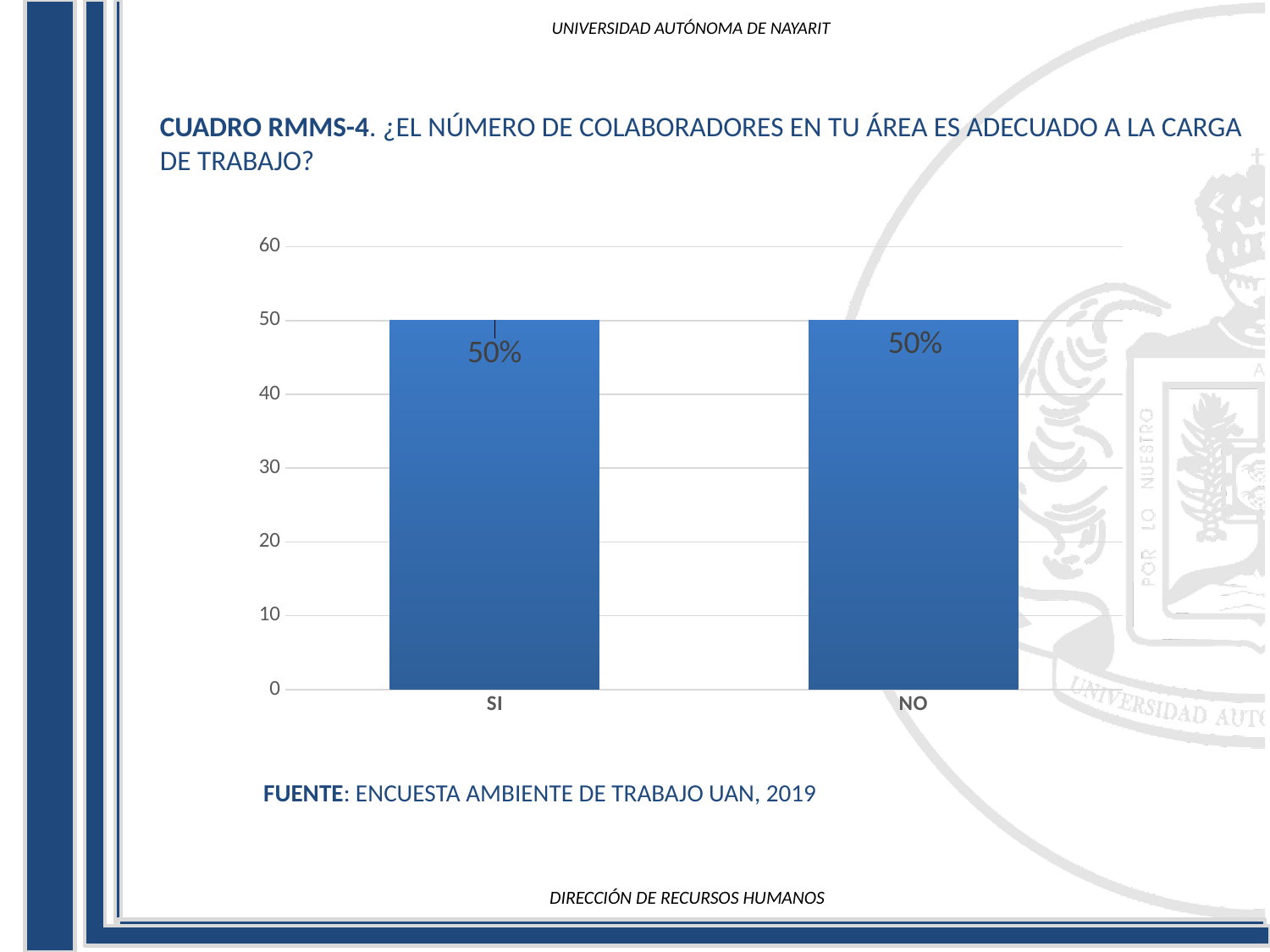
Is the value for NO greater or less than 60? less What is the highest value shown on the y axis? 60 What source is cited below the chart? ENCUESTA AMBIENTE DE TRABAJO UAN, 2019 What is the total of the values for SI and NO? 100% Is the value for SI greater or less than 40? greater What is the value for SI? 50% What kind of chart is shown on the slide? bar chart What is the difference between the values for SI and NO? 0% What is the value for NO? 50% How many categories are shown on the x axis? 2